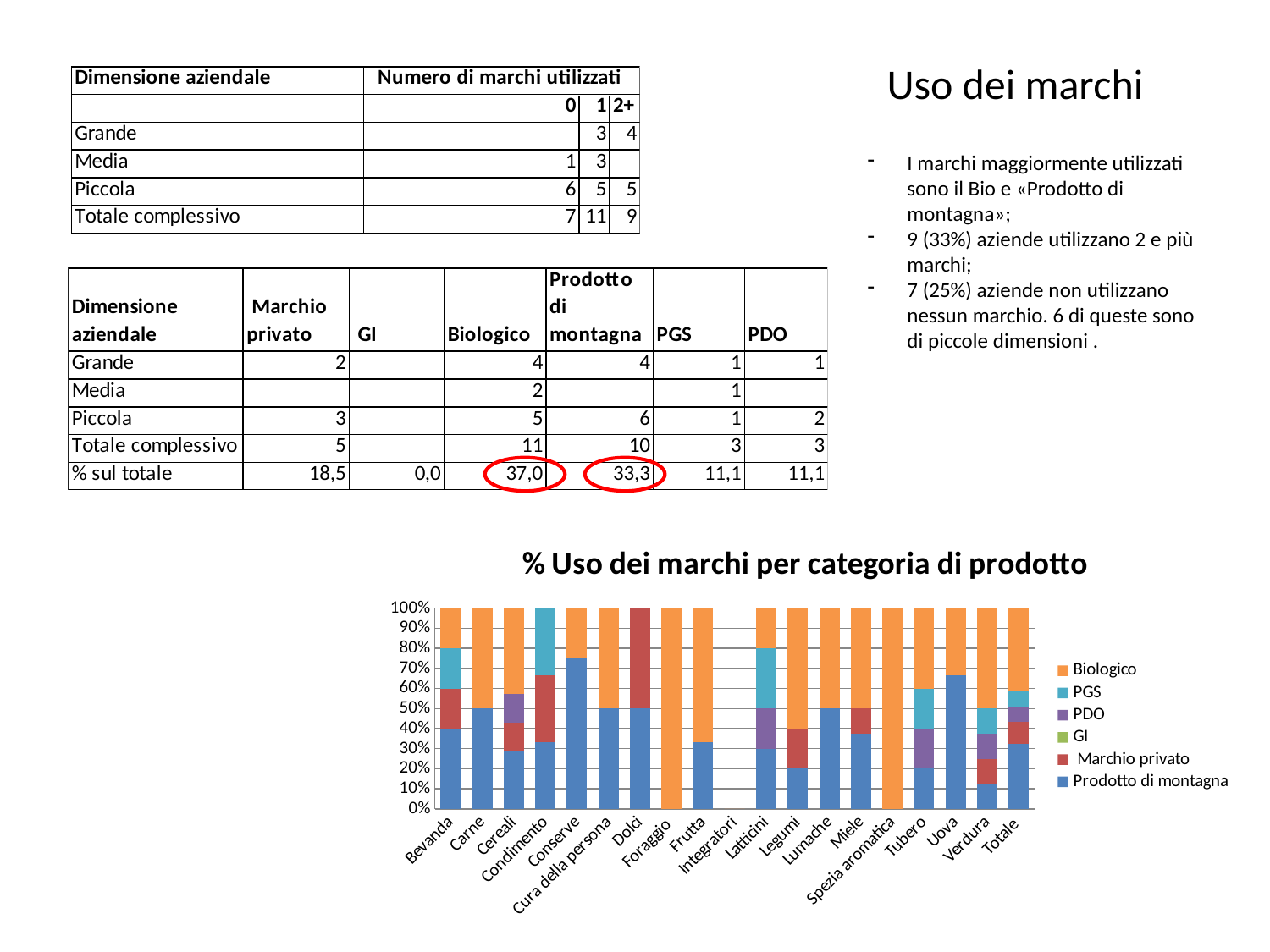
Is the Prodotto di montagna share for Conserve greater or less than 50%? greater How many series does the legend of the chart list? 6 Is the Prodotto di montagna share for Frutta greater or less than 50%? less Which has the larger Prodotto di montagna share, Conserve or Frutta? Conserve Which product category on the x axis has no bar plotted at all? Integratori What share does Biologico have for Spezia aromatica? 100% Is the Prodotto di montagna share for Uova greater or less than 50%? greater What kind of chart is shown on the slide? Stacked bar chart What is the title of the chart? % Uso dei marchi per categoria di prodotto What share does Biologico have for Foraggio? 100% How many product categories are labelled on the x axis of the chart? 19